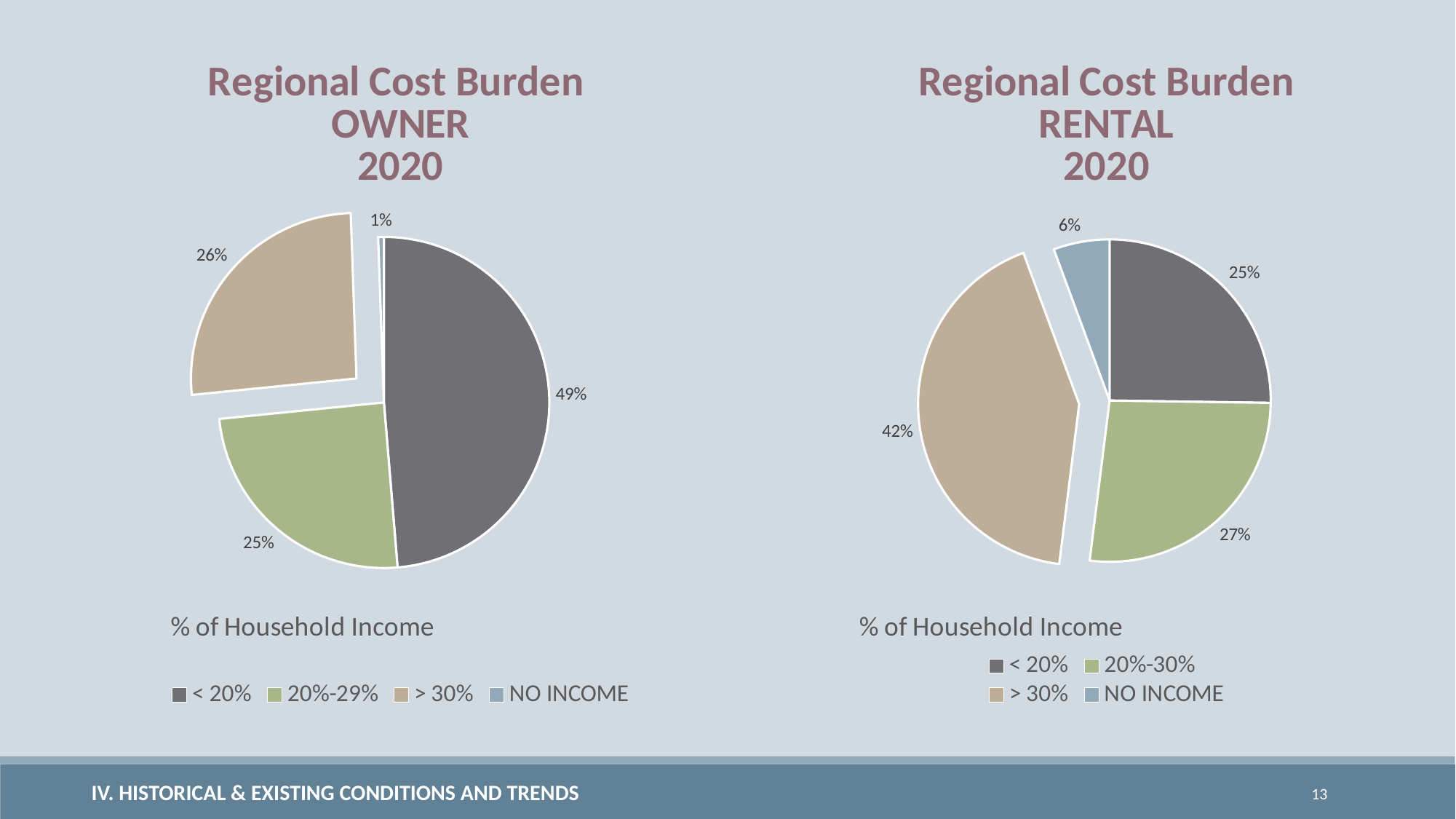
In the Regional Cost Burden OWNER 2020 chart, what is the value for NO INCOME? 1% What type of chart is the Regional Cost Burden OWNER 2020 chart? Pie chart How many categories does the legend of the Regional Cost Burden RENTAL 2020 chart list? 4 In the Regional Cost Burden RENTAL 2020 chart, which category has the smallest slice? NO INCOME In the Regional Cost Burden OWNER 2020 chart, which category has the largest slice? < 20% In the Regional Cost Burden RENTAL 2020 chart, which is larger: the < 20% slice or the > 30% slice? > 30% In the Regional Cost Burden RENTAL 2020 chart, which category has the largest slice? > 30% In the Regional Cost Burden OWNER 2020 chart, what share of households spend less than 20% of household income? 49% In the Regional Cost Burden OWNER 2020 chart, what is the difference in percentage points between the < 20% slice and the > 30% slice? 23 In the Regional Cost Burden OWNER 2020 chart, what colour is the > 30% slice? Tan In the Regional Cost Burden RENTAL 2020 chart, what share of households spend more than 30% of household income? 42% In the Regional Cost Burden RENTAL 2020 chart, what is the value for the 20%-30% category? 27%